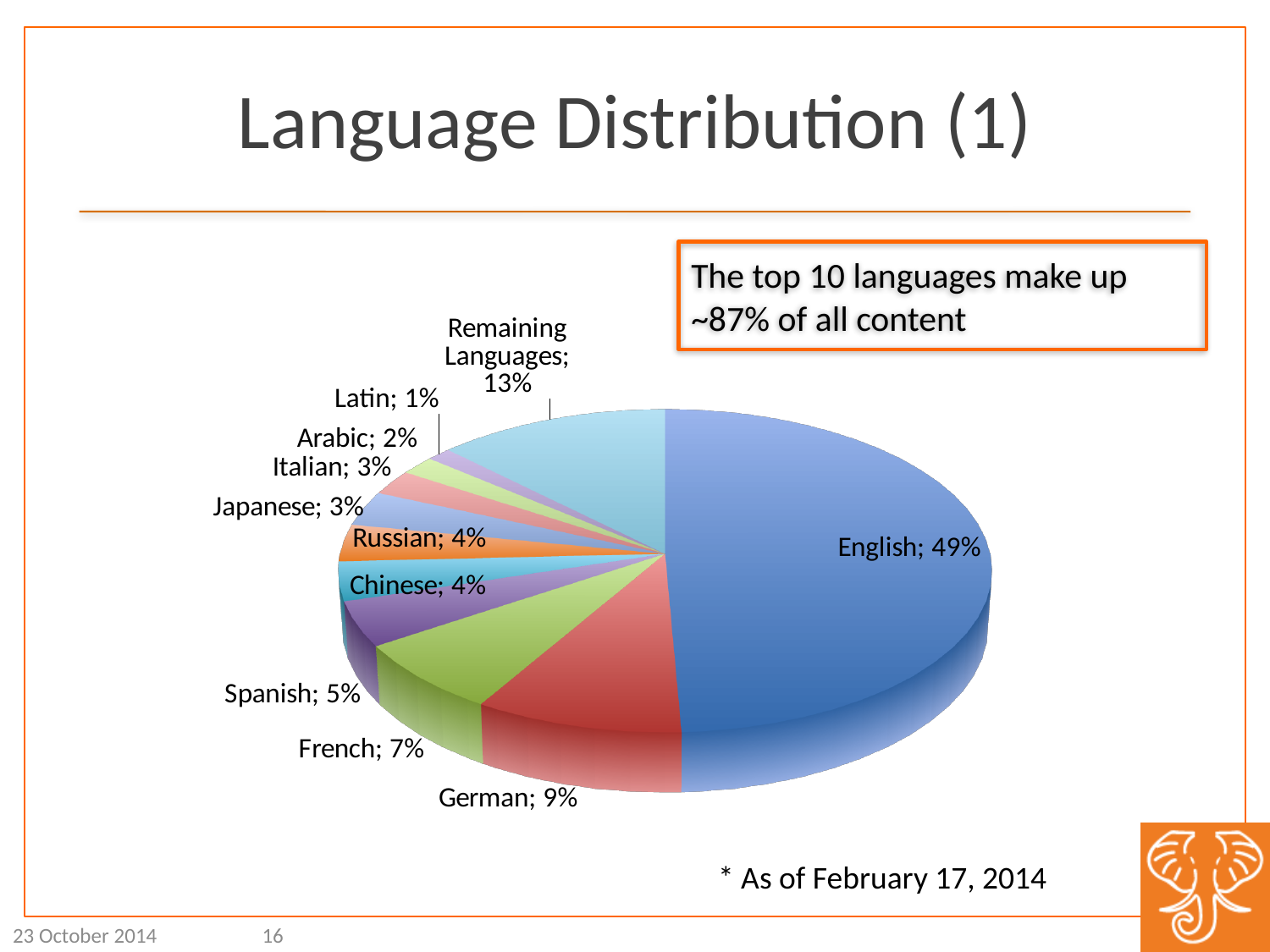
Which language has the largest slice of the pie? English What share of content is German? 9% How many slices does the pie chart have? 11 What is the difference between the shares for English and Remaining Languages? 36% What is the difference between the shares for German and French? 2% What is the title of the slide containing the pie chart? Language Distribution (1) What share of content is labelled Remaining Languages? 13% What kind of chart is shown on the slide? pie chart What share of content is English? 49% Which has a larger share, Spanish or Arabic? Spanish What share of content is Japanese? 3% Which language has the smallest slice of the pie? Latin